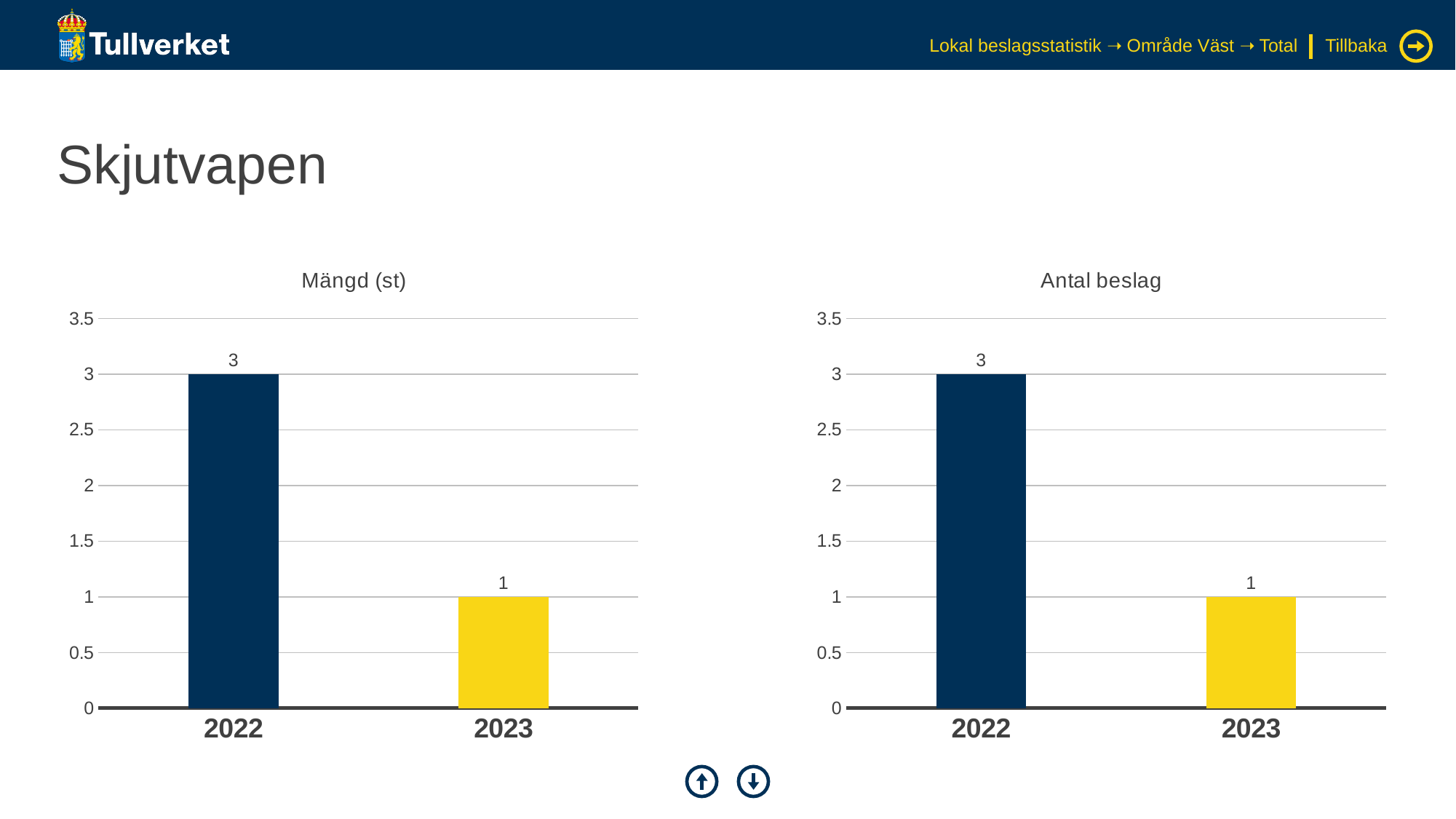
In the 'Mängd (st)' chart, which year has the highest value? 2022 In the 'Antal beslag' chart, which is larger, the value for 2022 or the value for 2023? 2022 In the 'Mängd (st)' chart, what is the difference between the values for 2022 and 2023? 2 What kind of chart is the 'Antal beslag' chart? bar chart In the 'Antal beslag' chart, which year has the lowest value? 2023 In the 'Antal beslag' chart, what is the value for 2022? 3 In the 'Antal beslag' chart, what is the value for 2023? 1 In the 'Mängd (st)' chart, what is the value for 2023? 1 In the 'Mängd (st)' chart, do the values rise or fall from 2022 to 2023? fall How many categories are shown on the x axis of the 'Mängd (st)' chart? 2 In the 'Mängd (st)' chart, what is the value for 2022? 3 In the 'Antal beslag' chart, is the value for 2022 greater or less than 2? greater